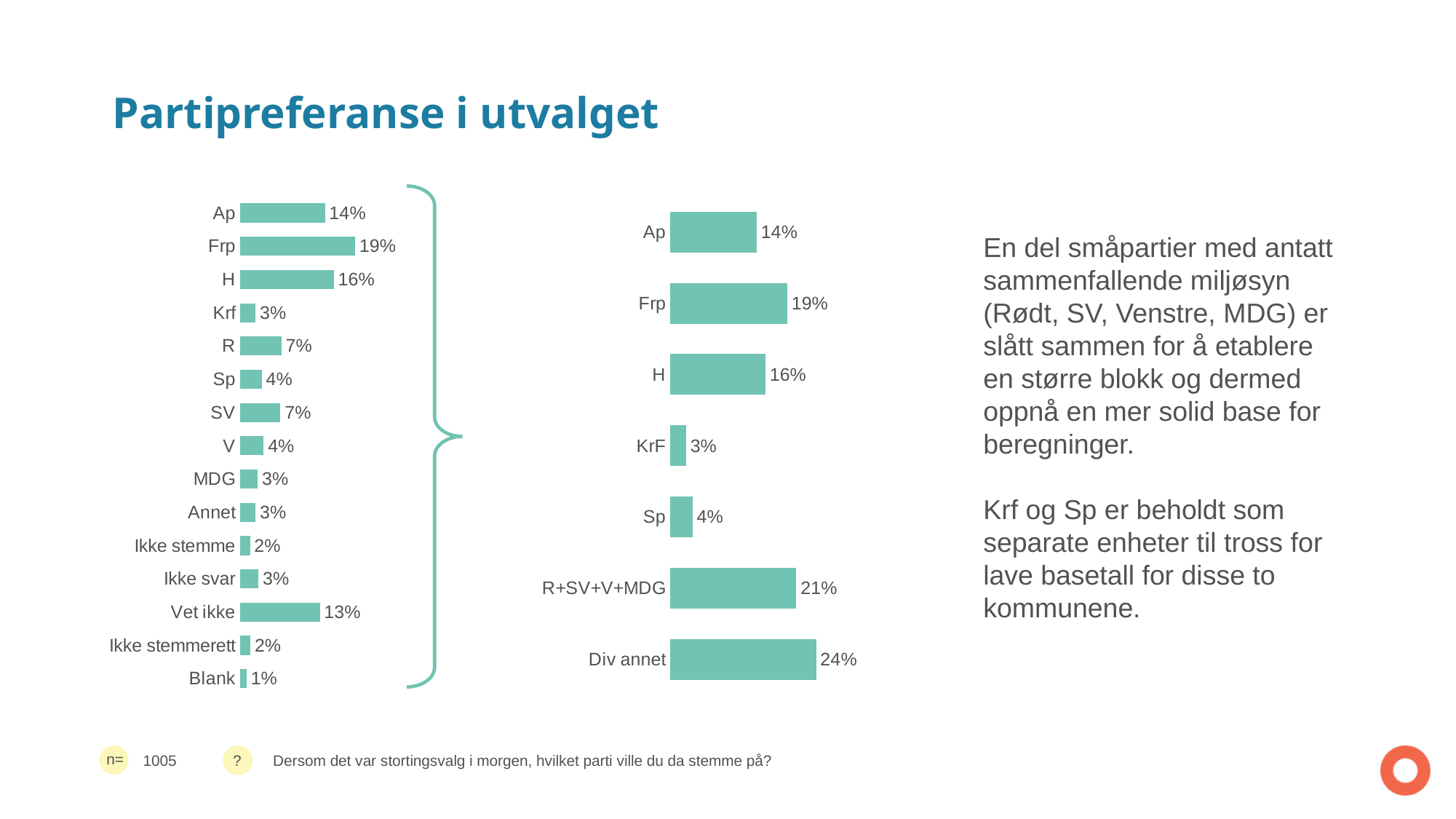
In the left chart, what is the difference between H and Ap? 2% In the left chart, which category has the highest value? Frp What kind of chart is the right chart? Bar chart How many categories does the right chart show? 7 In the right chart, which category has the highest value? Div annet How many categories does the left chart show? 15 In the right chart, what is the value for R+SV+V+MDG? 21% In the left chart, which is larger, R or Sp? R In the right chart, what is the difference between Div annet and Frp? 5% In the left chart, what is the value for Vet ikke? 13% In the left chart, which category has the lowest value? Blank In the left chart, what is the value for Frp? 19%